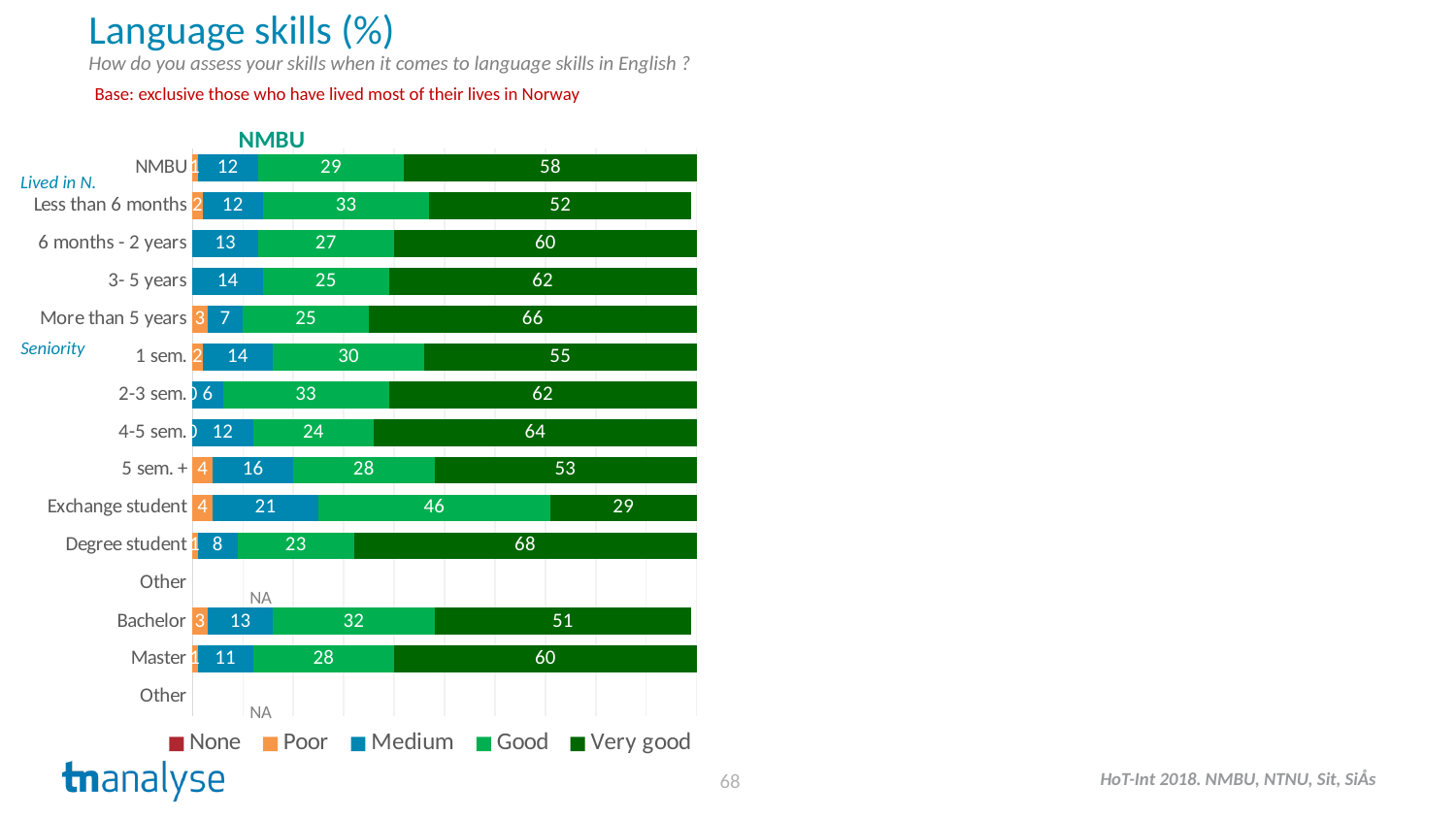
Which has a larger 'Good' value, Bachelor or Master? Bachelor How many categories are marked NA in the chart? 2 What is the 'Medium' value for 5 sem. +? 16 What is the 'Very good' value for the overall NMBU row? 58 What is the 'Very good' value for Degree student? 68 What is the 'Good' value for Exchange student? 46 What kind of chart is shown on the slide? Stacked bar chart What is the difference between the 'Very good' values for More than 5 years and Less than 6 months? 14 Which category has the highest 'Very good' value? Degree student Which legend entry is shown in the darkest green colour? Very good Which category has the lowest 'Very good' value? Exchange student How many series does the legend list? 5